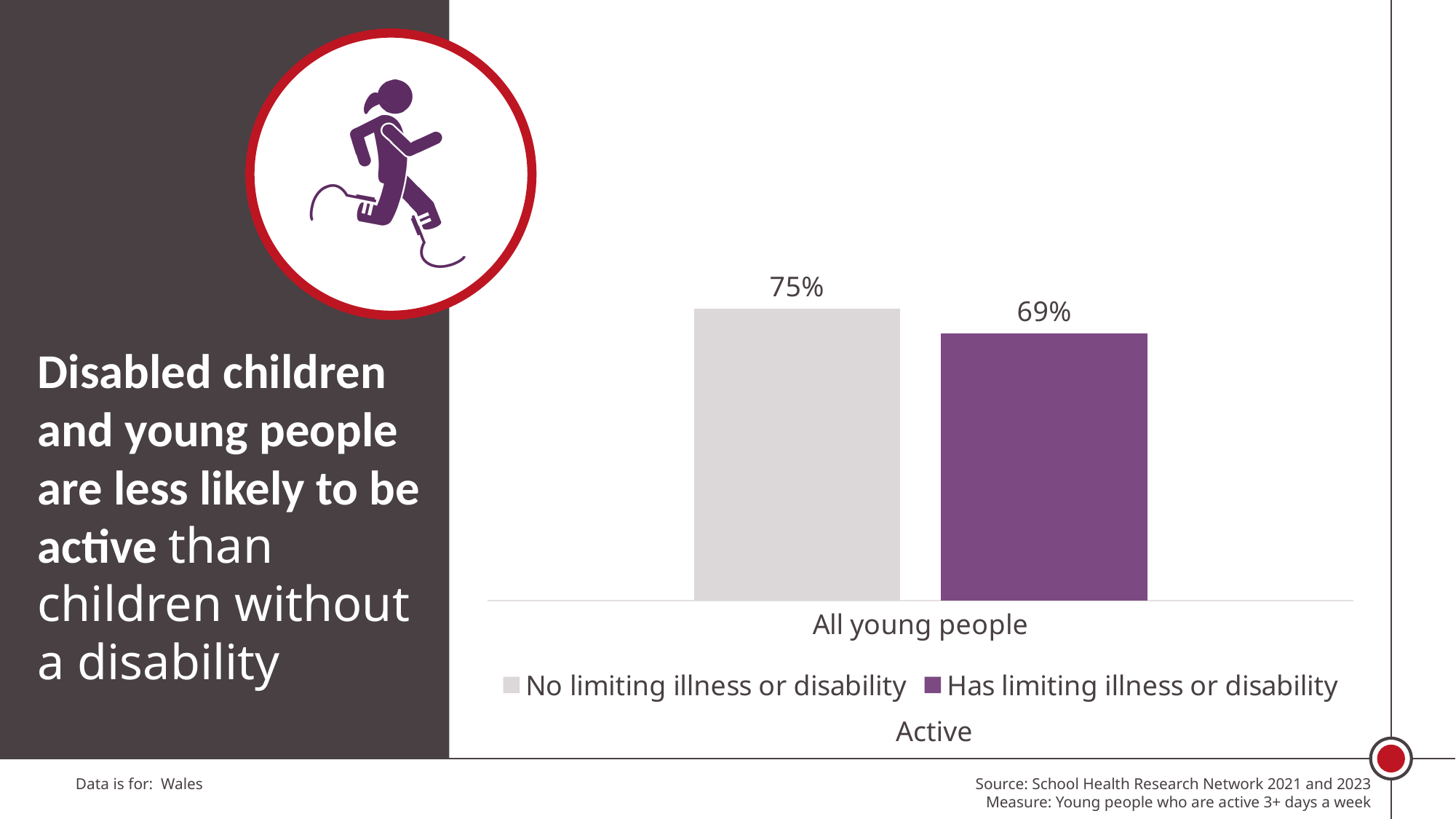
What percentage of young people who have a limiting illness or disability are active? 69% How many series does the chart legend list? 2 Which legend entry is shown in purple? Has limiting illness or disability How many categories are shown on the x axis of the chart? 1 What percentage of young people with no limiting illness or disability are active? 75% What is the category label on the x axis of the chart? All young people Which group has the lower share of active young people? Has limiting illness or disability What is the difference in percentage points between the 'No limiting illness or disability' bar and the 'Has limiting illness or disability' bar? 6 percentage points What type of chart is shown on the slide? bar chart Which group has the higher share of active young people? No limiting illness or disability Is the value for 'Has limiting illness or disability' larger or smaller than the value for 'No limiting illness or disability'? smaller